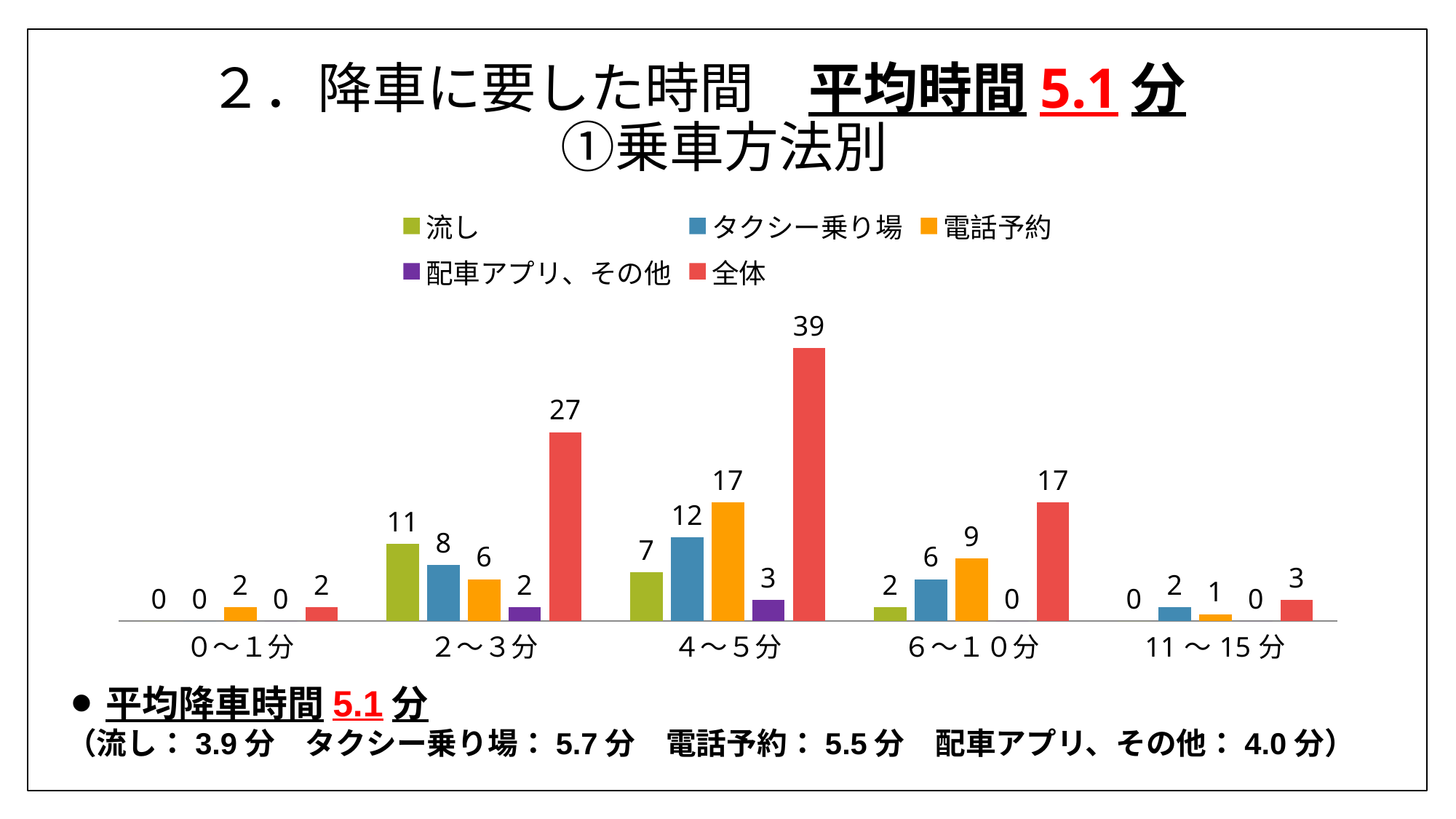
What is the value for タクシー乗り場 in the 2～3分 category? 8 In which category is the 全体 series highest? 4～5分 What type of chart is shown on the slide? bar chart How many series does the legend list? 5 Which is larger in the 4～5分 category: 電話予約 or タクシー乗り場? 電話予約 What is the value for 全体 in the 4～5分 category? 39 In which category is the 流し series highest? 2～3分 Which series is shown in red in the legend? 全体 What is the difference between 電話予約 and 流し in the 4～5分 category? 10 What is the difference between the 全体 values for 4～5分 and 2～3分? 12 What is the value for 電話予約 in the 6～10分 category? 9 How many categories are shown on the x axis? 5